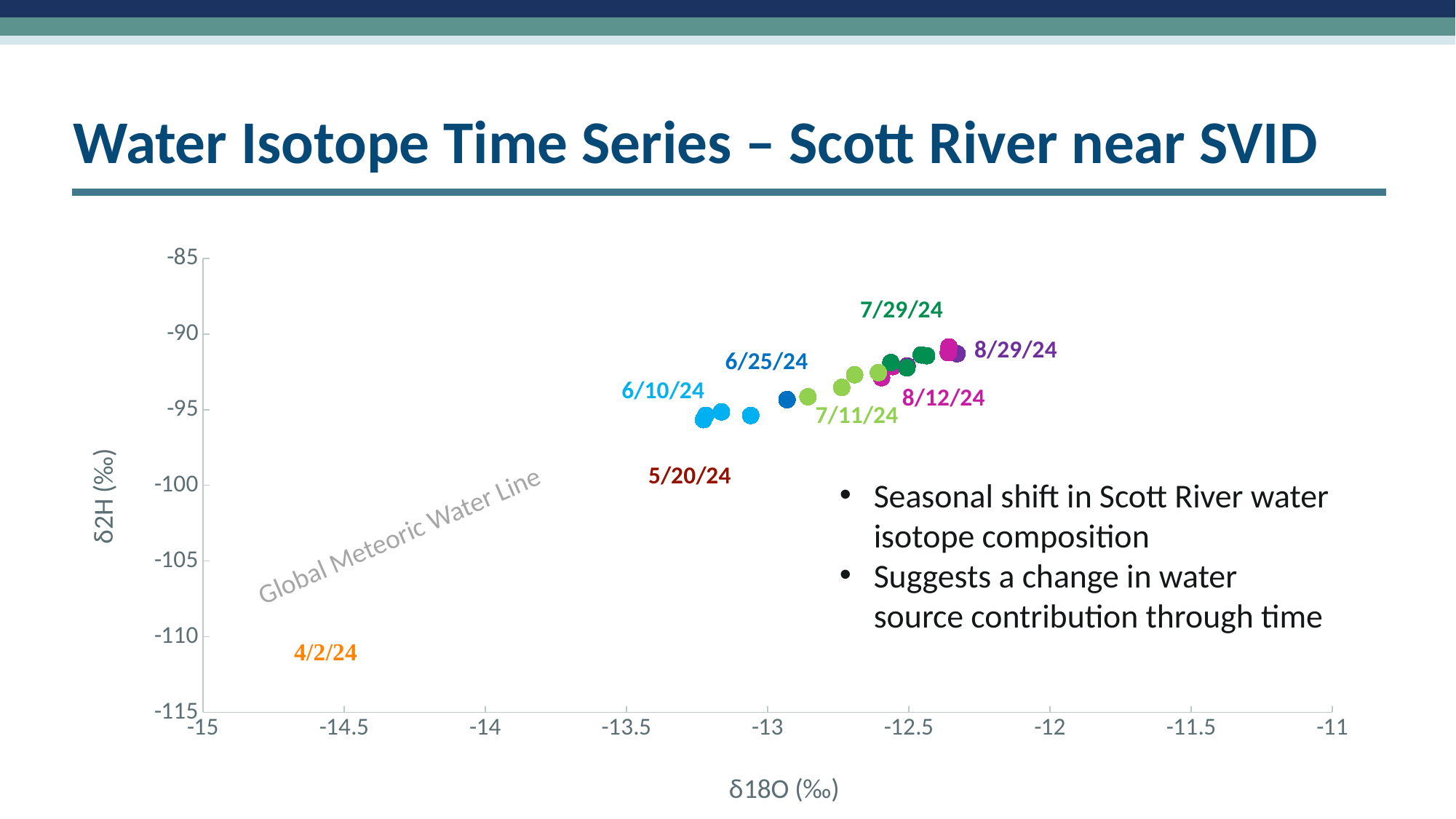
What kind of chart is shown on the slide? scatter chart What is the label of the vertical axis? δ2H (‰) Is the δ2H value for the 6/25/24 point greater or less than -90? less Is the δ2H value for the 8/29/24 points greater or less than -95? greater Which date has the lowest δ18O among the plotted points? 6/10/24 How many sampling dates are labelled on the chart? 8 What is the title of the slide's chart? Water Isotope Time Series – Scott River near SVID Is the δ18O value for the 7/29/24 points greater or less than -13? greater Which has the higher δ18O value, the 6/10/24 points or the 8/29/24 points? 8/29/24 As δ18O increases along the x axis, do the plotted δ2H values rise or fall? rise Which has the lower δ2H value, the 6/10/24 points or the 7/29/24 points? 6/10/24